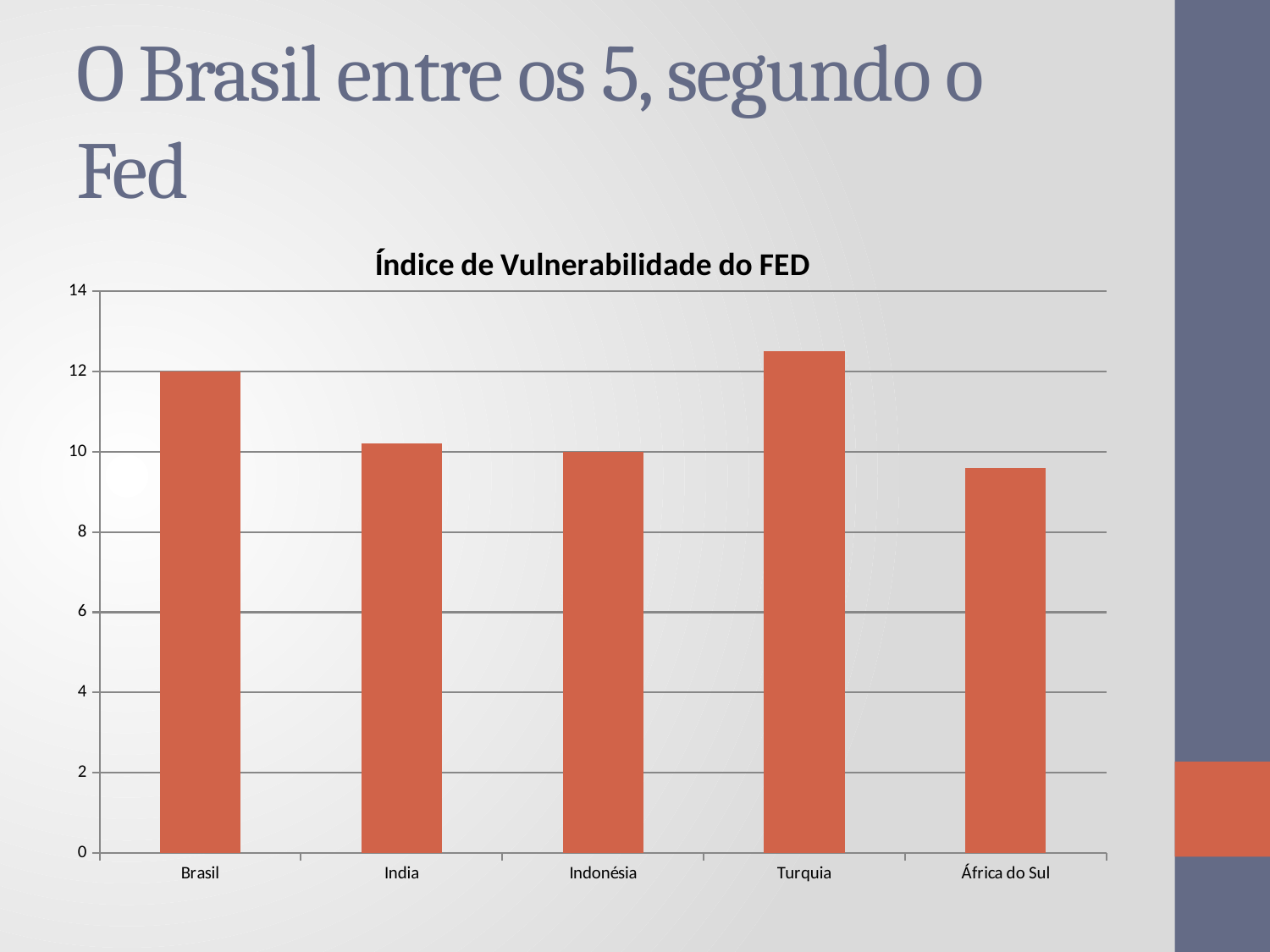
Is the value for África do Sul greater or less than 10? less Is the value for India greater or less than 10? greater What is the value for Indonésia in the chart? 10 What is the value for Brasil in the chart? 12 Which has a larger value, Brasil or India? Brasil What type of chart is shown on the slide? bar chart Which country has the highest value in the chart? Turquia What is the title of the chart? Índice de Vulnerabilidade do FED Is the value for Turquia greater or less than 12? greater How many countries are shown on the x axis of the chart? 5 Which country has the lowest value in the chart? África do Sul Which has a larger value, Indonésia or Turquia? Turquia